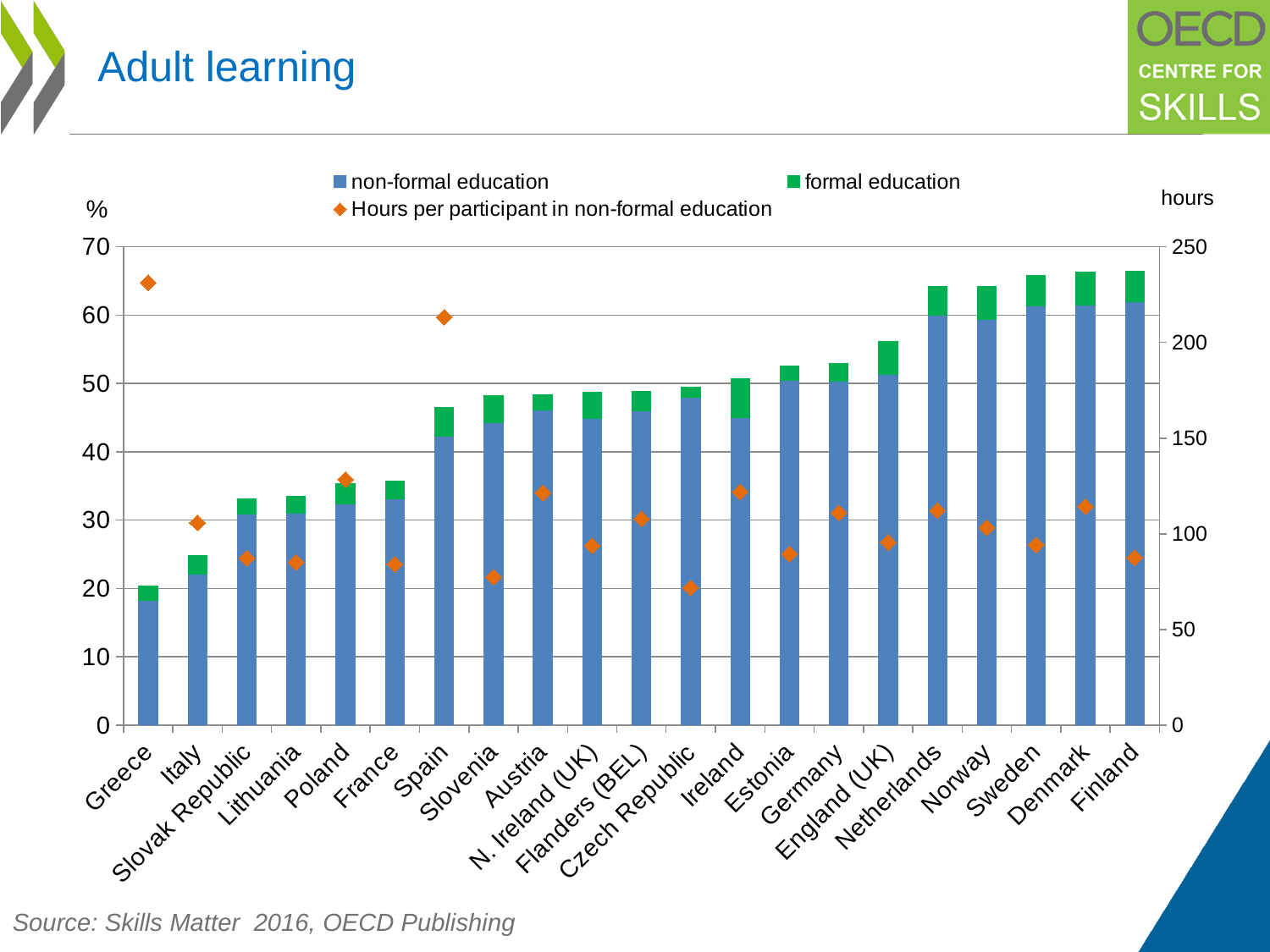
Is the total participation bar for Finland greater or less than 60%? greater Which has the larger total participation bar, Spain or France? Spain How many series does the legend list? 3 Which series is shown in green in the legend? formal education How many countries or regions are shown on the x axis? 21 What kind of chart is shown on the slide? combination chart (stacked bars with diamond markers) Which country has the lowest total participation bar? Greece Is the total participation bar for Italy greater or less than 30%? less Which country has the highest value for hours per participant in non-formal education? Greece Is the hours per participant value for the Czech Republic greater or less than 100 hours? less Do the total participation bars generally rise or fall from left to right along the x axis? rise